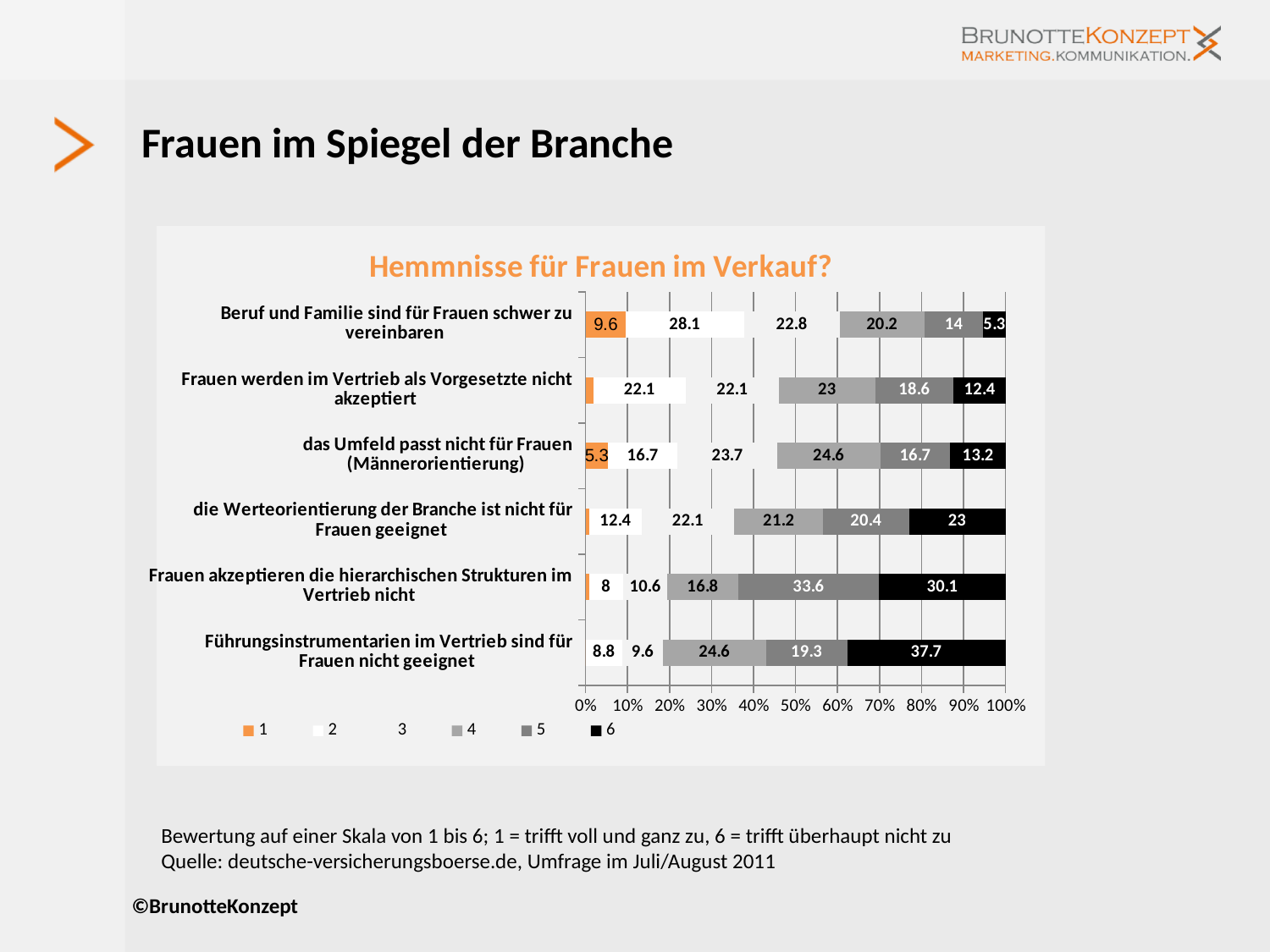
How many series does the legend list? 6 What is the value for series 2 in the category 'Beruf und Familie sind für Frauen schwer zu vereinbaren'? 28.1 What is the value for series 5 in the category 'Frauen akzeptieren die hierarchischen Strukturen im Vertrieb nicht'? 33.6 What type of chart is shown on the slide? stacked bar chart Which category has the lowest value for series 6? Beruf und Familie sind für Frauen schwer zu vereinbaren What is the title of the chart? Hemmnisse für Frauen im Verkauf? Which is larger: the series 4 value for 'das Umfeld passt nicht für Frauen (Männerorientierung)' or the series 4 value for 'Beruf und Familie sind für Frauen schwer zu vereinbaren'? das Umfeld passt nicht für Frauen (Männerorientierung) Which category has the highest value for series 6? Führungsinstrumentarien im Vertrieb sind für Frauen nicht geeignet What is the difference between the series 6 values for 'Führungsinstrumentarien im Vertrieb sind für Frauen nicht geeignet' and 'Beruf und Familie sind für Frauen schwer zu vereinbaren'? 32.4 What is the value for series 6 in the category 'Führungsinstrumentarien im Vertrieb sind für Frauen nicht geeignet'? 37.7 How many categories (statements) are shown in the chart? 6 What is the value for series 1 in the category 'das Umfeld passt nicht für Frauen (Männerorientierung)'? 5.3